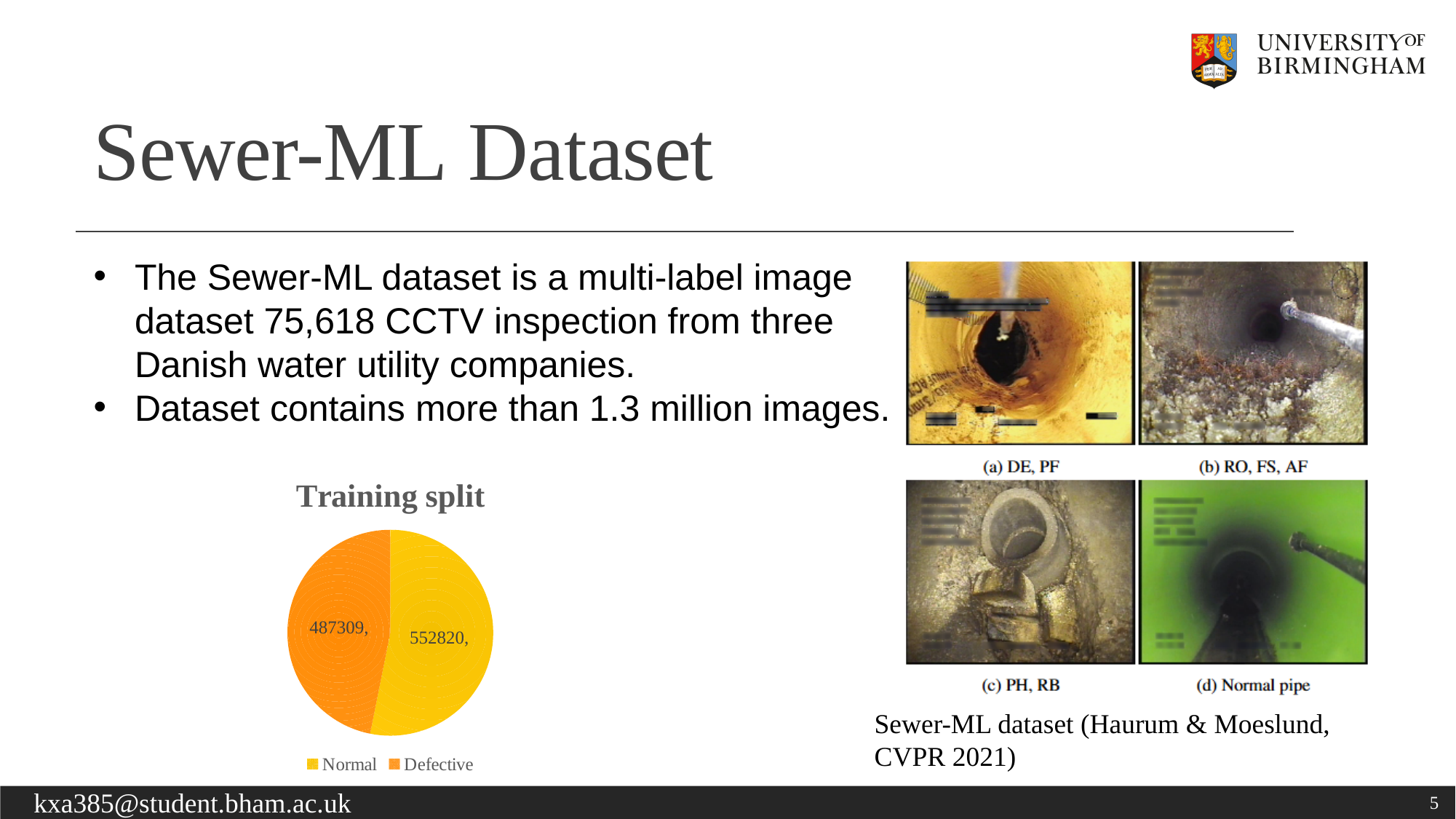
In the "Training split" pie chart, what is the value for Normal? 552820 In the "Training split" pie chart, what is the value for Defective? 487309 What is the title of the pie chart on the slide? Training split What is the total of the two slices in the "Training split" pie chart? 1040129 Which slice of the "Training split" pie chart is the largest? Normal Which slice of the "Training split" pie chart is the smallest? Defective What kind of chart is the "Training split" chart? pie chart How many entries does the legend of the "Training split" pie chart list? 2 In the "Training split" pie chart, which is larger, Normal or Defective? Normal In the "Training split" pie chart, what is the difference between the Normal and Defective values? 65511 Which colour represents Defective in the "Training split" pie chart? orange How many slices does the "Training split" pie chart have? 2